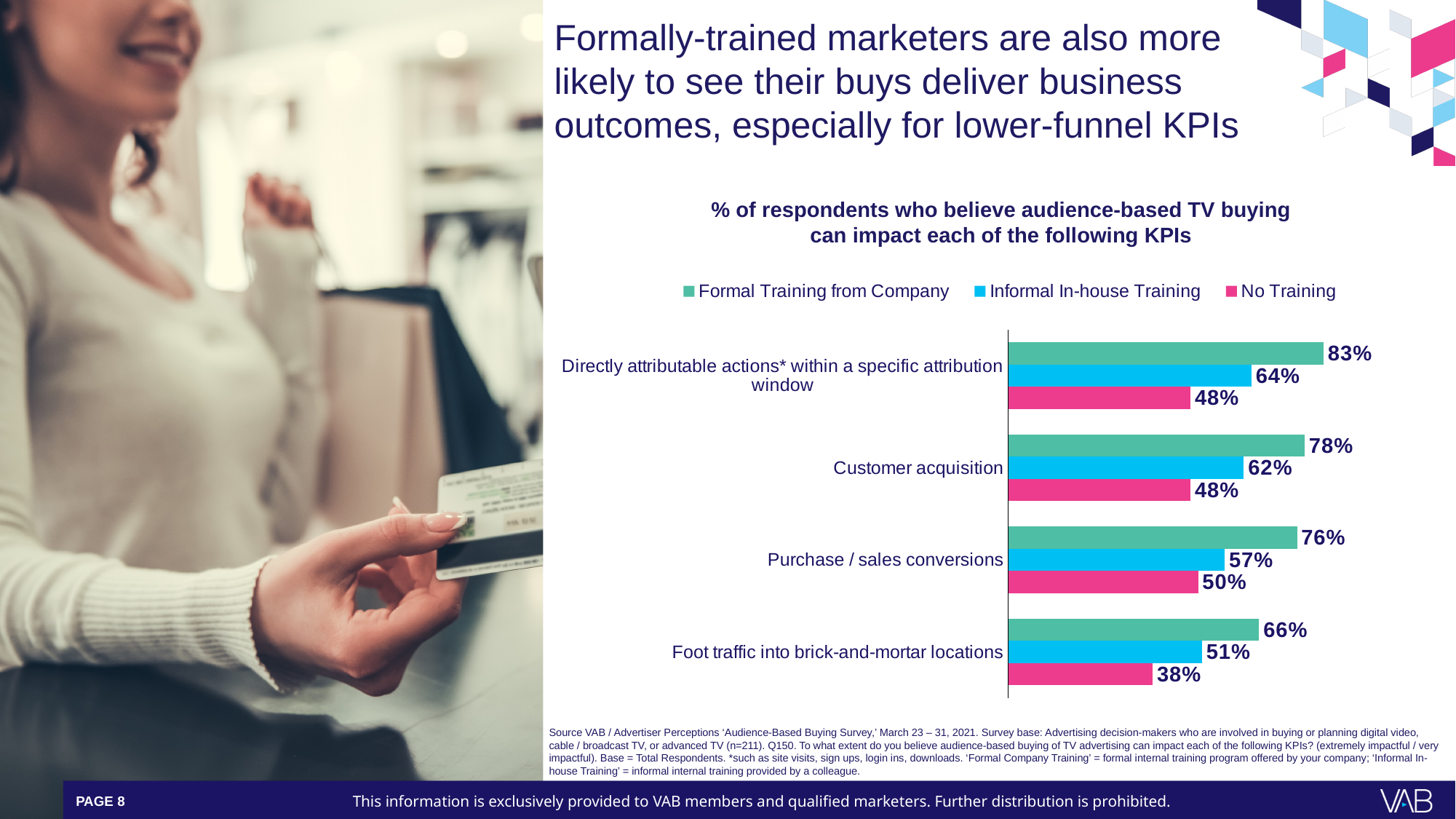
Which KPI has the highest value for Formal Training from Company? Directly attributable actions* within a specific attribution window What is the difference between the Formal Training from Company and No Training values for Directly attributable actions* within a specific attribution window? 35 percentage points What is the difference between the Informal In-house Training and No Training values for Customer acquisition? 14 percentage points Which colour represents the No Training series in the chart? Pink What percentage of respondents with Formal Training from Company believe audience-based TV buying can impact Customer acquisition? 78% Which is larger for Foot traffic into brick-and-mortar locations: the Informal In-house Training value or the No Training value? Informal In-house Training What type of chart is shown on the slide? Bar chart Which KPI has the lowest value for No Training? Foot traffic into brick-and-mortar locations What is the Informal In-house Training value for Purchase / sales conversions? 57% How many KPI categories are shown in the chart? 4 How many series does the legend list? 3 What is the No Training value for Foot traffic into brick-and-mortar locations? 38%